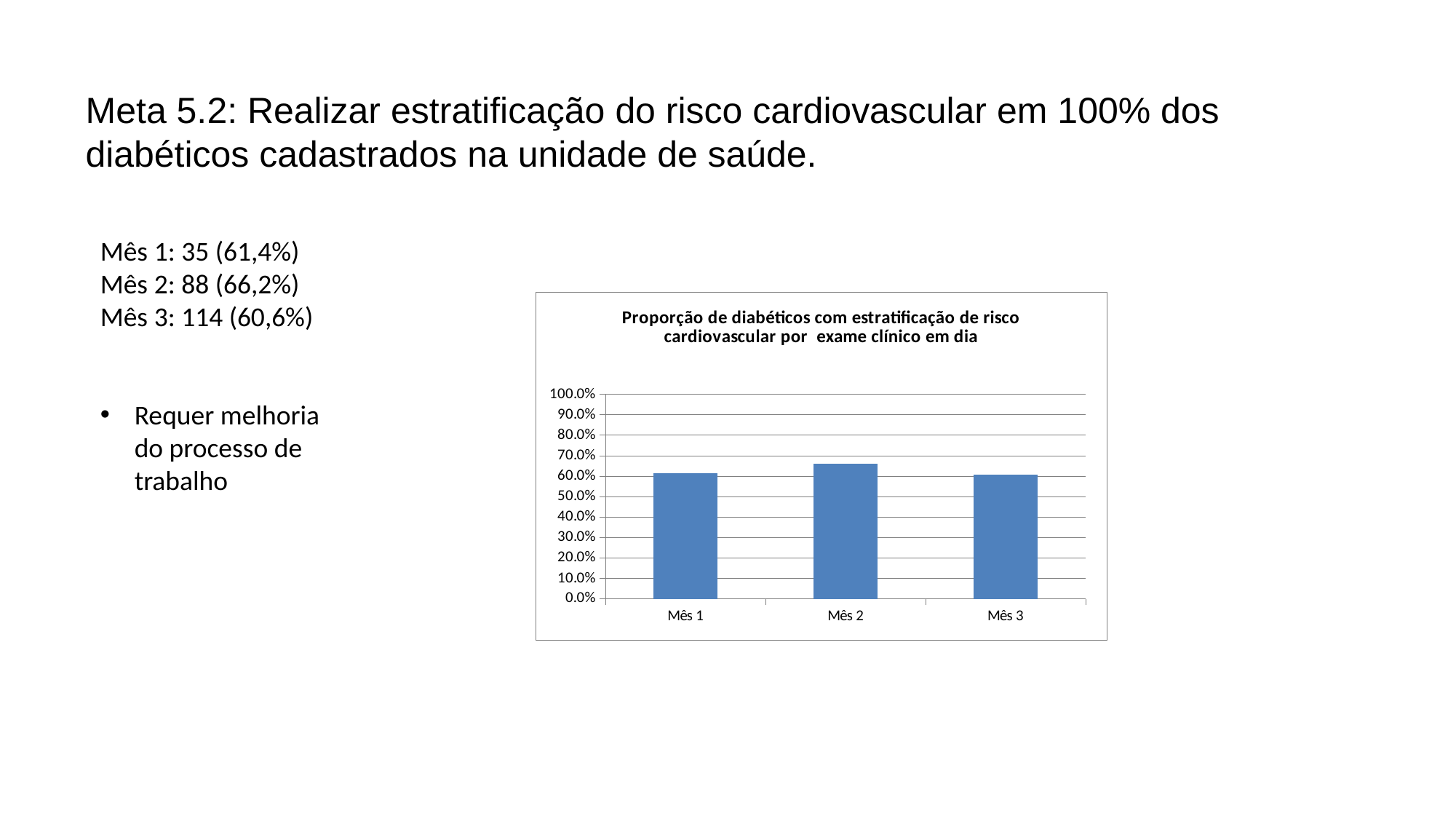
According to the slide, what proportion is reported for Mês 1? 61,4% Which is larger, the value for Mês 2 or the value for Mês 1? Mês 2 Is the value for Mês 1 greater or less than 70.0%? less What kind of chart is shown on the slide? bar chart According to the slide, what proportion is reported for Mês 2? 66,2% How many categories (months) are plotted on the chart? 3 Is the value for Mês 2 greater or less than 70.0%? less Which month has the highest proportion of diabetics with cardiovascular risk stratification? Mês 2 Is the value for Mês 3 greater or less than 50.0%? greater What is the title of the chart? Proporção de diabéticos com estratificação de risco cardiovascular por exame clínico em dia Using the percentages printed on the slide, what is the difference between Mês 2 and Mês 1? 4,8%